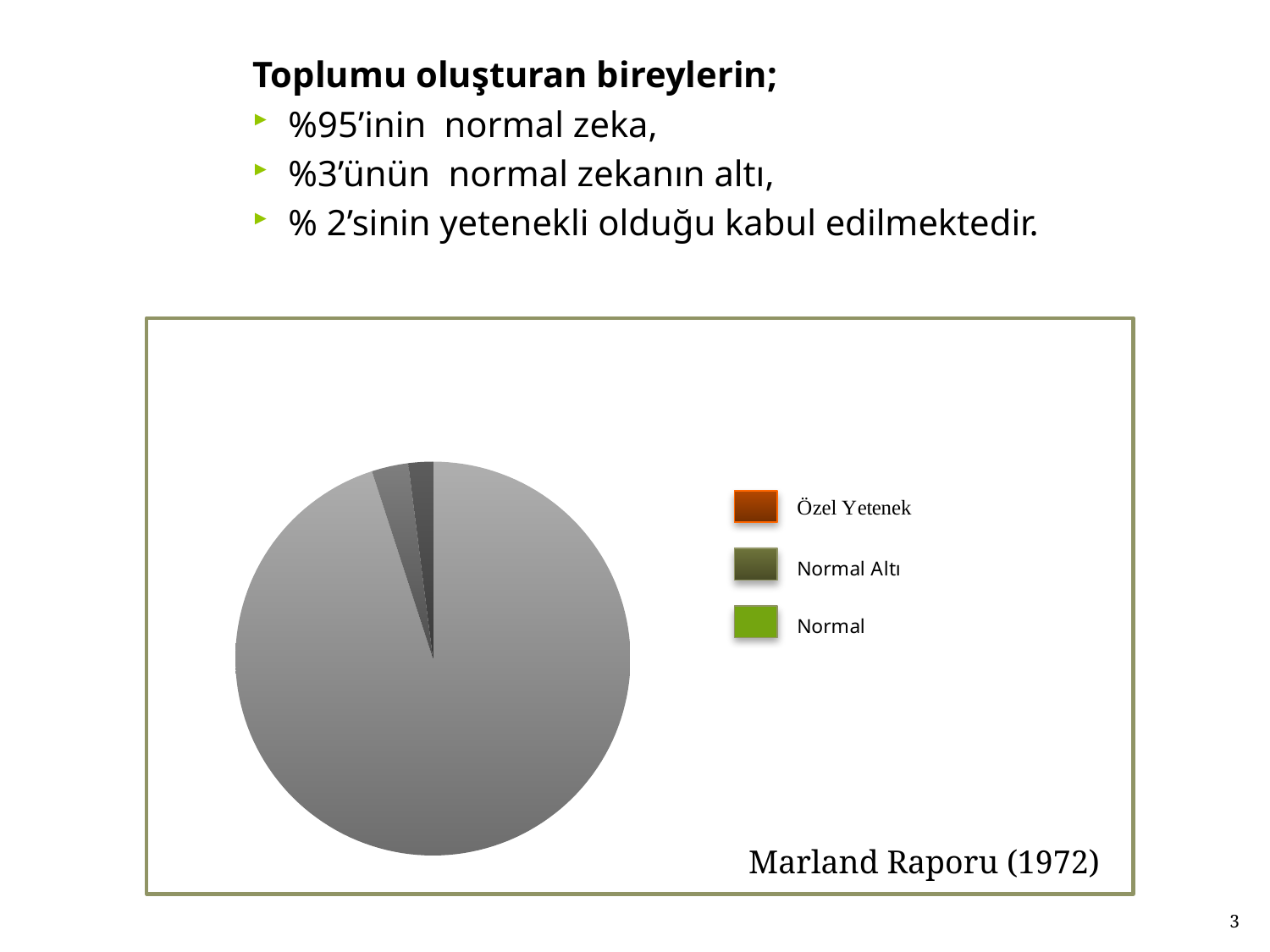
How many slices does the pie chart have? 3 Which category takes up the largest slice of the pie chart? Normal What kind of chart is shown on the slide? pie chart What are the three legend entries of the pie chart? Özel Yetenek, Normal Altı, Normal How many entries does the legend of the pie chart list? 3 What source is cited in the bottom right corner of the chart area? Marland Raporu (1972) Is the slice for Normal larger or smaller than the slice for Normal Altı? larger